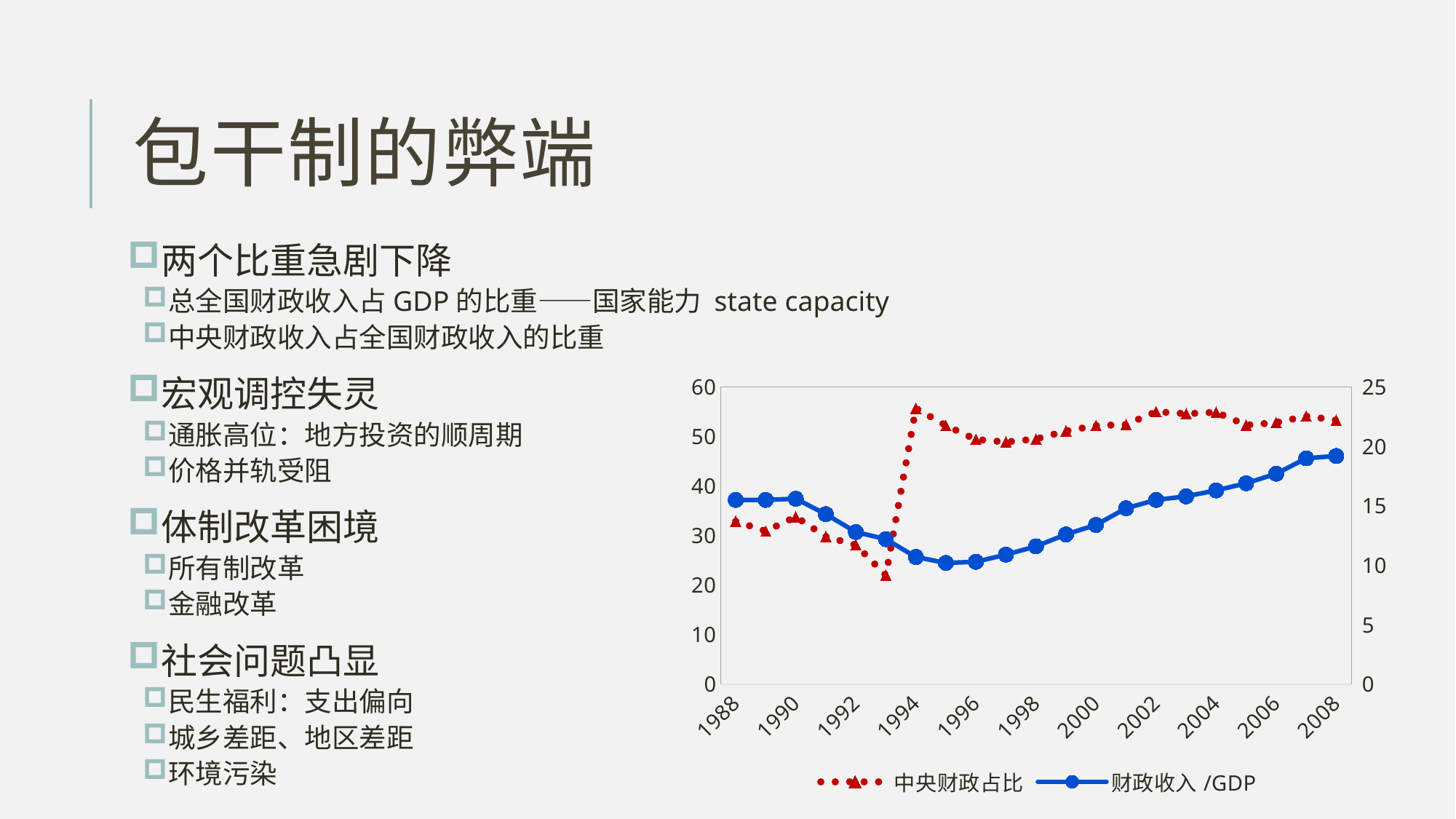
Does the 财政收入/GDP series rise or fall from 1996 to 2008? rise In which year is the 中央财政占比 series at its lowest? 1993 What kind of chart is shown on the slide? line chart How many year labels are shown on the x axis of the chart? 11 What is the highest value shown on the left vertical axis of the chart? 60 Is the value of 财政收入/GDP in 2008 greater or less than 15 on the right axis? greater How many series does the chart legend list? 2 Which is larger for 中央财政占比: the value in 1993 or the value in 1994? 1994 Is the value of 中央财政占比 in 1994 greater or less than 50 on the left axis? greater Is the value of 财政收入/GDP in 1996 greater or less than 15 on the right axis? less Does the 中央财政占比 series rise or fall from 1988 to 1993? fall